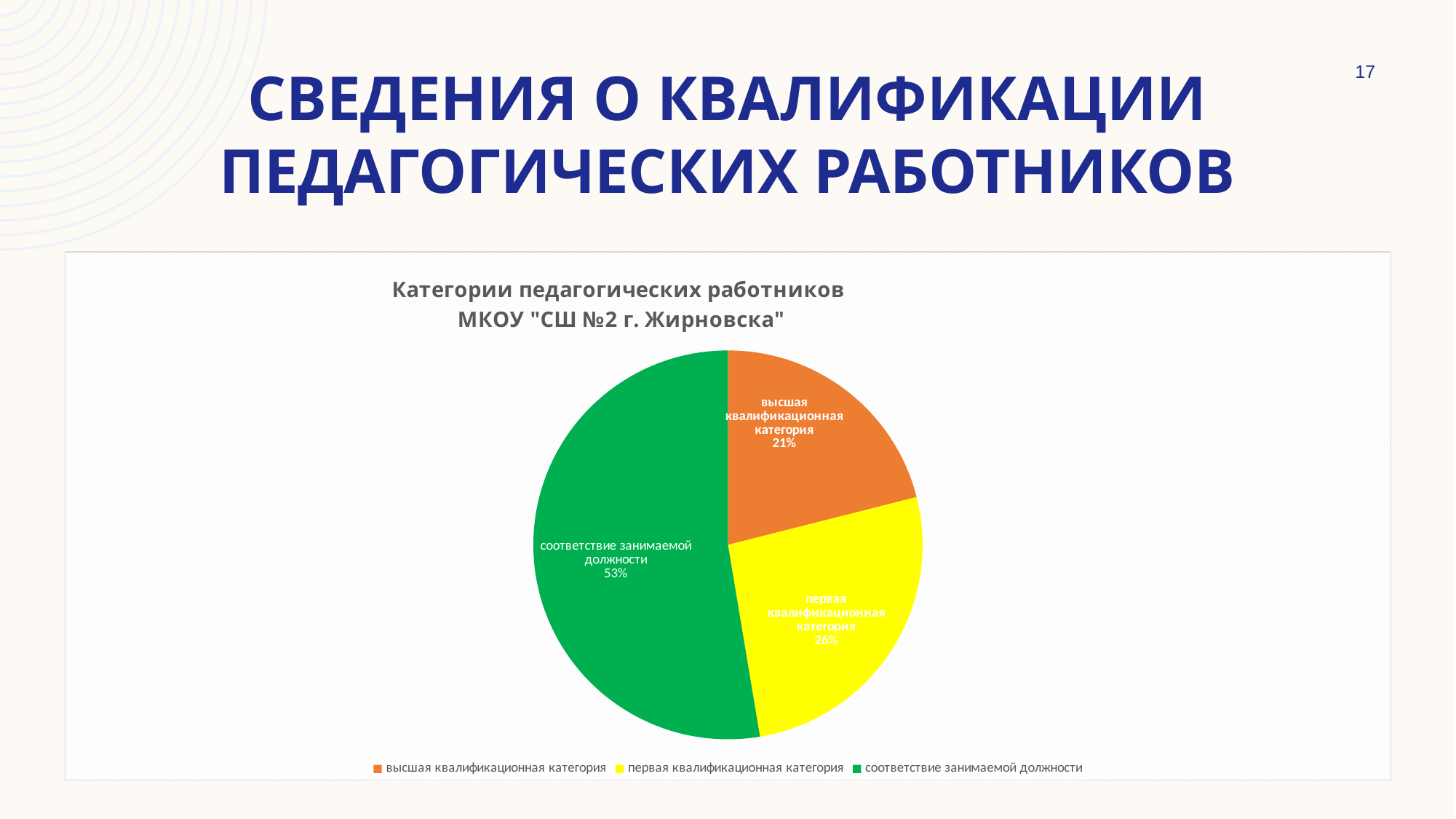
What share of the pie does "высшая квалификационная категория" have? 21% Which is larger: the share for "первая квалификационная категория" or for "высшая квалификационная категория"? первая квалификационная категория Which category has the smallest slice of the pie? высшая квалификационная категория What colour is the slice for "первая квалификационная категория"? yellow What is the title of the chart? Категории педагогических работников МКОУ "СШ №2 г. Жирновска" What is the difference in percentage points between "соответствие занимаемой должности" and "первая квалификационная категория"? 27 What share of the pie does "соответствие занимаемой должности" have? 53% Which category has the largest slice of the pie? соответствие занимаемой должности How many slices does the pie chart have? 3 What share of the pie does "первая квалификационная категория" have? 26% What kind of chart is shown on the slide? pie chart What is the difference in percentage points between "первая квалификационная категория" and "высшая квалификационная категория"? 5